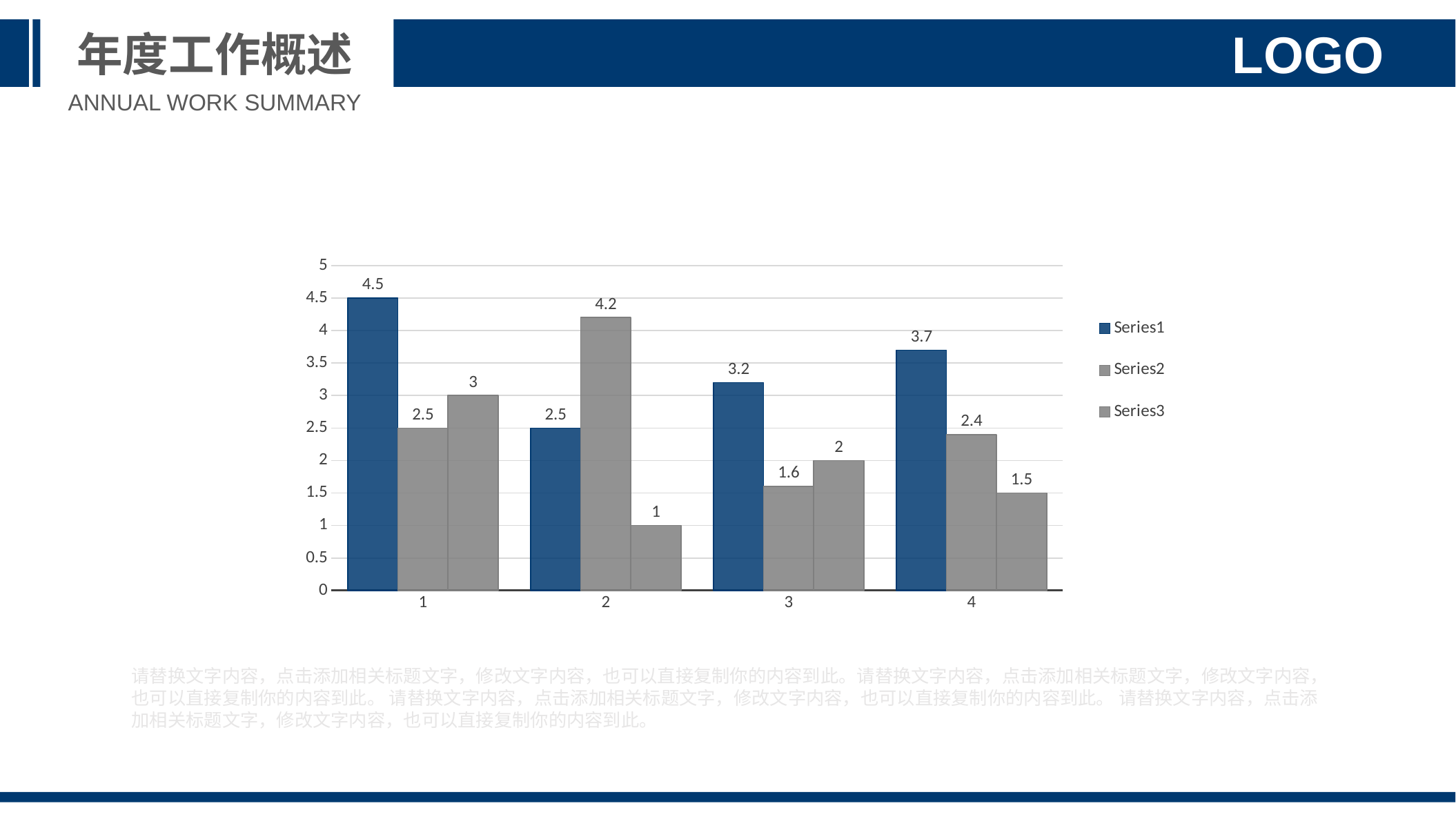
What is the highest value labelled in the category 2 group of bars? 4.2 How many series does the legend list? 3 What is the value of Series1 for category 3? 3.2 Which category has the lowest Series1 value? 2 Which category has the highest Series1 value? 1 How many categories are shown on the x axis? 4 What is the lowest value labelled in the category 2 group of bars? 1 What is the value of Series1 for category 4? 3.7 What type of chart is shown on the slide? bar chart What is the difference between the Series1 values for category 1 and category 2? 2 What is the value of Series1 for category 1? 4.5 Which is larger, the Series1 value for category 3 or for category 4? category 4